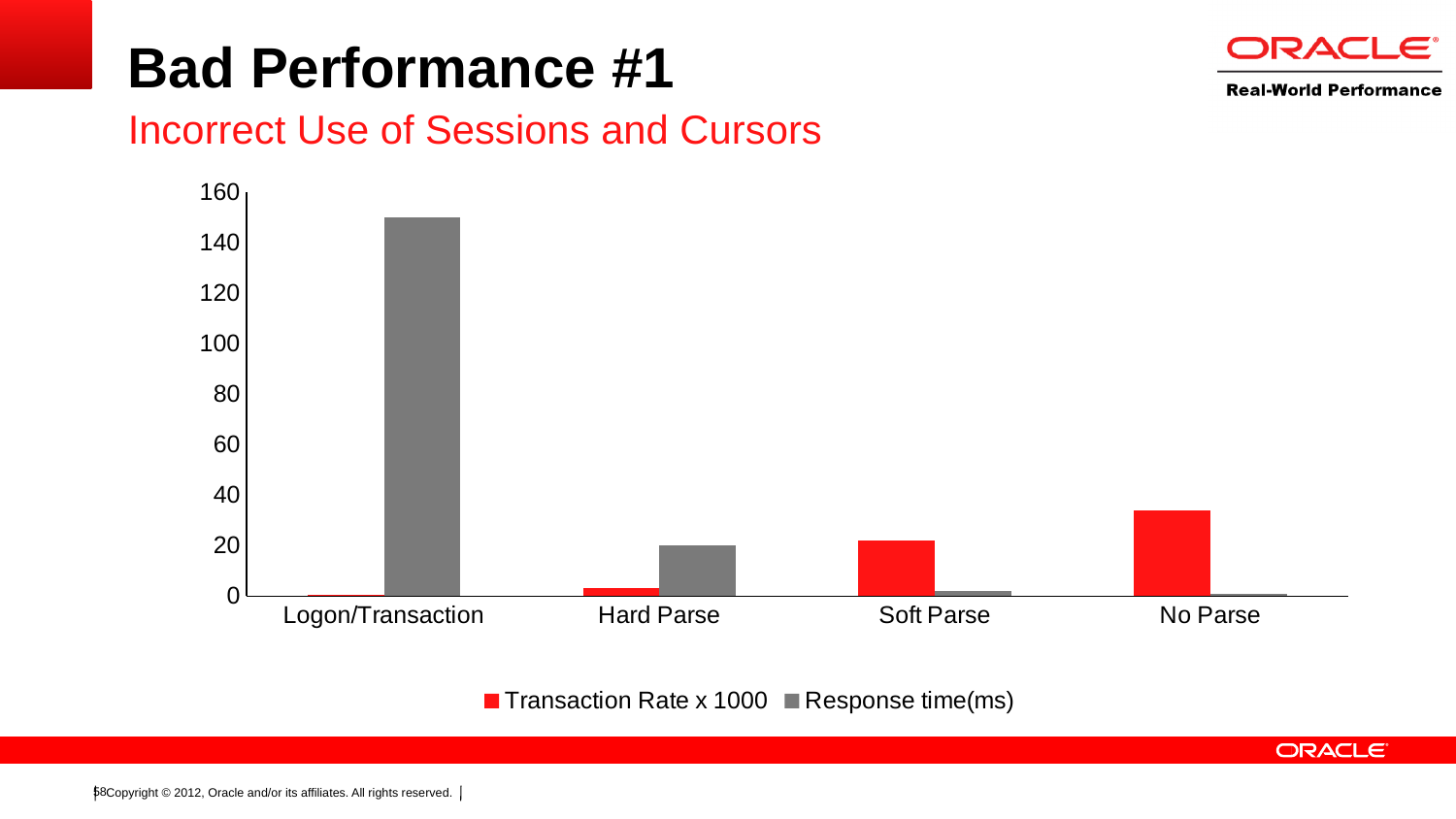
What kind of chart is shown on the slide? bar chart Is the Transaction Rate x 1000 value for No Parse greater or less than 40? less How many categories are shown on the x axis of the chart? 4 Is the Transaction Rate x 1000 value for Hard Parse greater or less than 20? less For Hard Parse, which is larger, the Transaction Rate x 1000 or the Response time(ms)? Response time(ms) Which category has the lowest Transaction Rate x 1000? Logon/Transaction How many series does the chart's legend list? 2 Which category has the highest Transaction Rate x 1000? No Parse Which category has the highest Response time(ms)? Logon/Transaction Is the Response time(ms) value for Logon/Transaction greater or less than 140? greater Which has the larger Transaction Rate x 1000, Soft Parse or No Parse? No Parse What colour represents the Transaction Rate x 1000 series in the chart? red